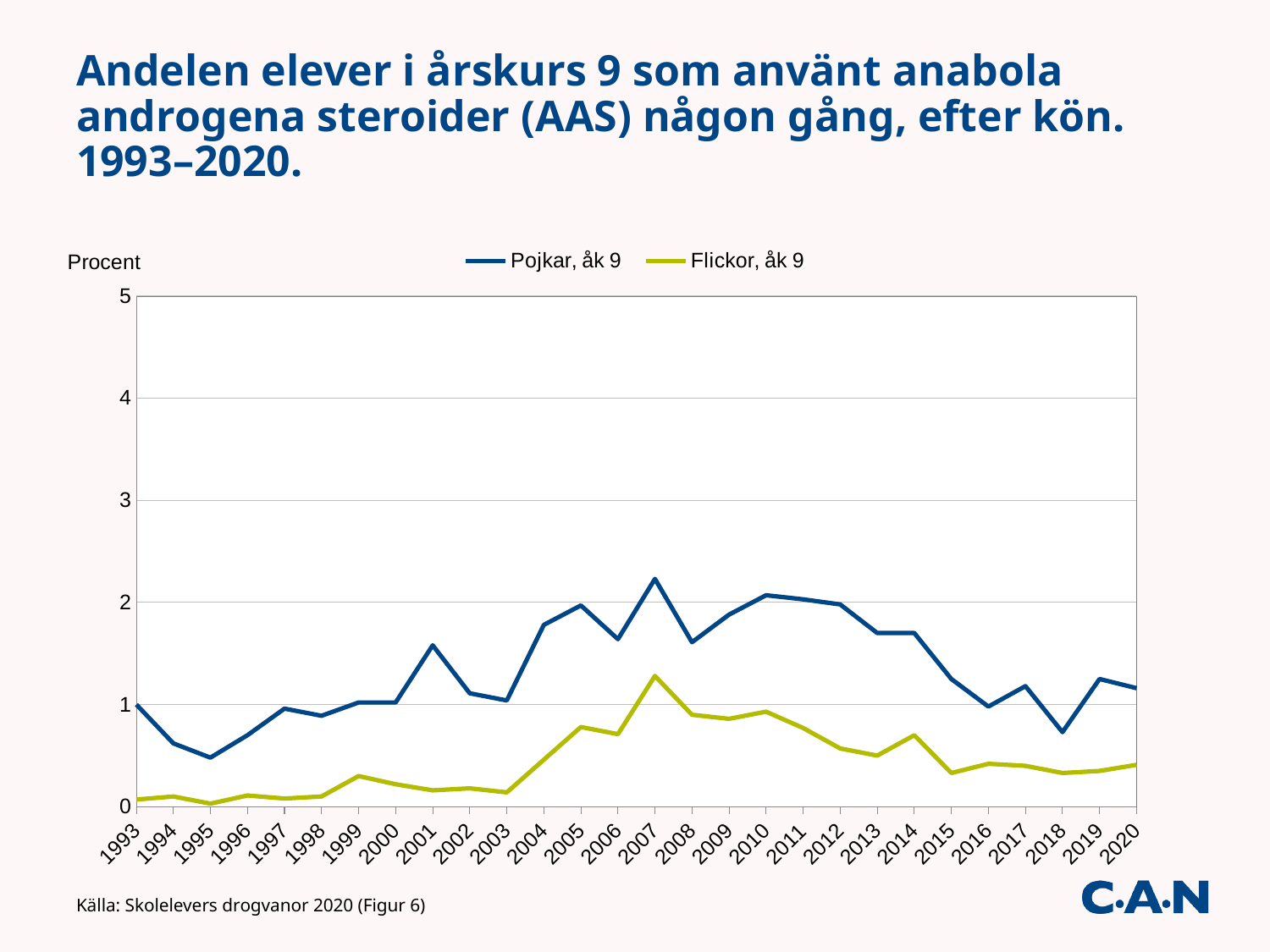
Is the value for Pojkar, åk 9 in 1995 greater or less than 1? less In which year is the Pojkar, åk 9 series at its lowest? 1995 What label is shown on the vertical axis? Procent Is the value for Flickor, åk 9 in 2007 greater or less than 1? greater Does the Pojkar, åk 9 series rise or fall between 2010 and 2016? Fall In which year does the Pojkar, åk 9 series reach its highest value? 2007 In which year does the Flickor, åk 9 series reach its highest value? 2007 Is the value for Pojkar, åk 9 in 2007 greater or less than 2? greater How many series does the legend list? 2 Which series has the larger value in 2010, Pojkar, åk 9 or Flickor, åk 9? Pojkar, åk 9 How many years are plotted along the x axis? 28 What kind of chart is shown on the slide? Line chart